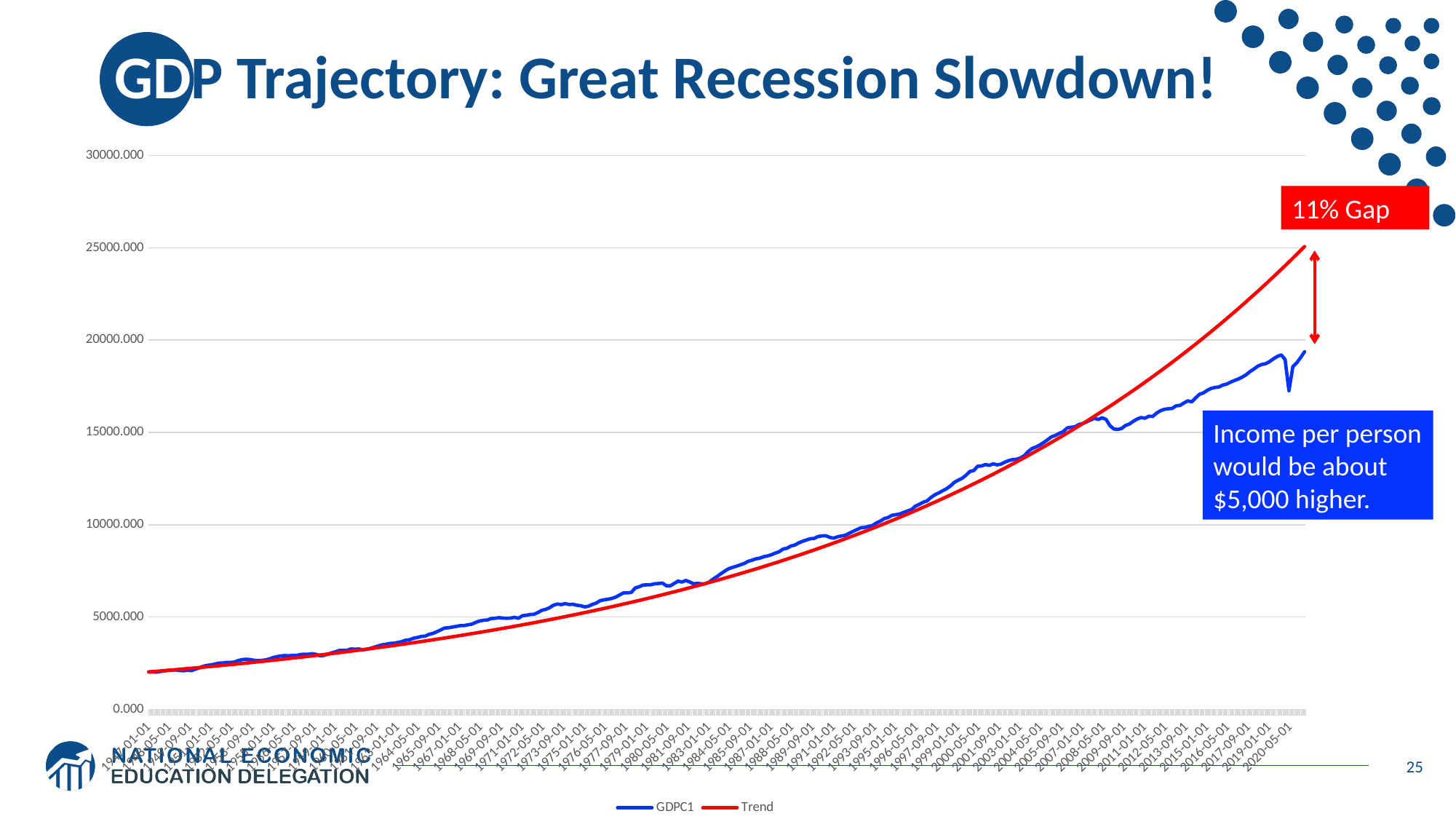
At the right end of the chart, which series has the higher value, GDPC1 or Trend? Trend What is the highest value shown on the y axis? 30000.000 What percentage gap between the Trend line and GDPC1 is annotated on the chart? 11% Gap Do the GDPC1 values generally rise or fall from left to right along the x axis? rise What kind of chart is shown on the slide? line chart How many series does the legend list? 2 At the left end of the chart (1947), is the GDPC1 value greater or less than 5000.000? less What are the names of the two series in the legend? GDPC1 and Trend What colour is the Trend line? red At the right end of the chart, is the Trend value greater or less than 20000.000? greater At the right end of the chart, is the GDPC1 value greater or less than 20000.000? less